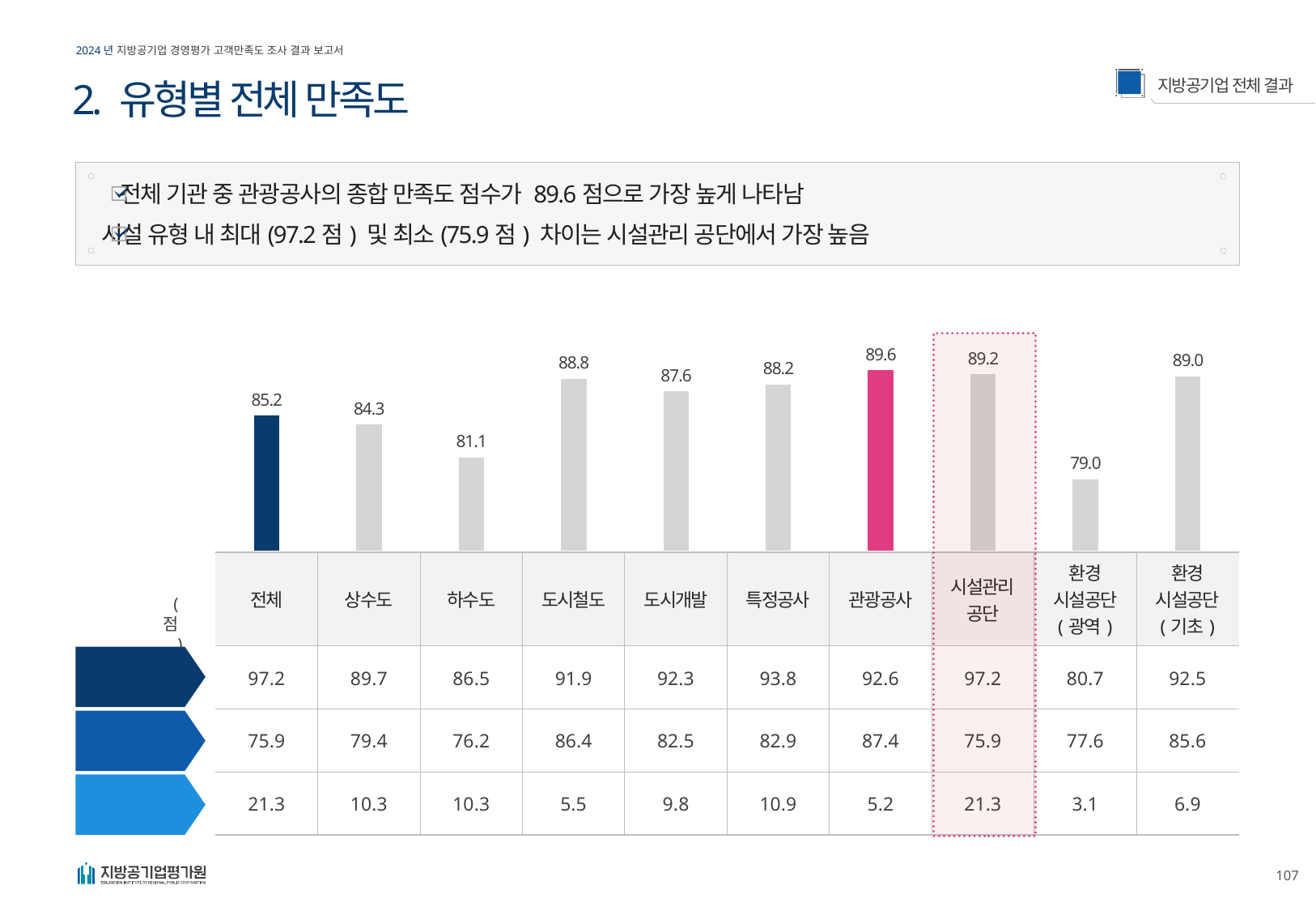
What is the value shown for 환경시설공단(기초) in the bar chart? 89.0 Which category has the highest value in the bar chart? 관광공사 What is the value shown for 관광공사 in the bar chart? 89.6 What is the value shown for 하수도 in the bar chart? 81.1 Which bar in the chart is coloured pink? 관광공사 What kind of chart is shown on the slide? bar chart What is the value shown for 전체 in the bar chart? 85.2 Which is larger in the bar chart, the value for 특정공사 or the value for 도시개발? 특정공사 What is the difference between the values for 관광공사 and 환경시설공단(광역) in the bar chart? 10.6 Which category has the lowest value in the bar chart? 환경시설공단(광역) What is the difference between the values for 도시철도 and 상수도 in the bar chart? 4.5 How many categories are shown in the bar chart? 10